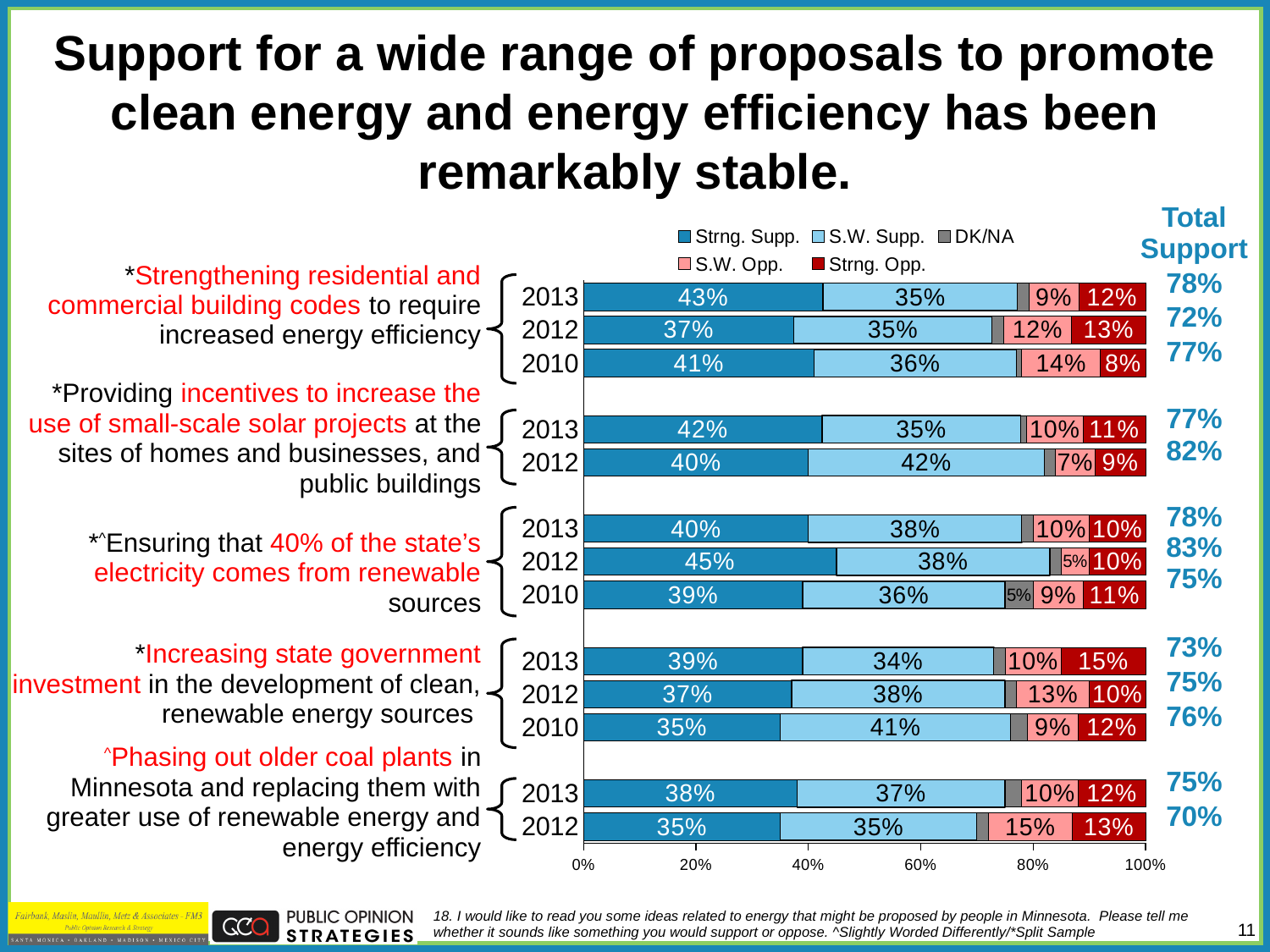
What is the S.W. Supp. value for providing incentives for small-scale solar projects in 2012? 42% For phasing out older coal plants, which year has the larger Strng. Supp. value, 2013 or 2012? 2013 What is the Strng. Supp. value for strengthening residential and commercial building codes in 2013? 43% What is the Total Support for ensuring that 40% of the state's electricity comes from renewable sources in 2012? 83% What is the difference in Strng. Supp. for strengthening building codes between 2013 and 2012? 6 percentage points What is the Strng. Opp. value for increasing state government investment in clean, renewable energy in 2013? 15% What kind of chart is shown on the slide? bar chart How many bars are plotted in the chart in total? 13 How many series does the chart legend list? 5 What is the lowest Total Support value shown on the slide? 70% For ensuring that 40% of the state's electricity comes from renewable sources, which year has the highest Strng. Supp. value? 2012 What is the S.W. Opp. value for phasing out older coal plants in 2012? 15%